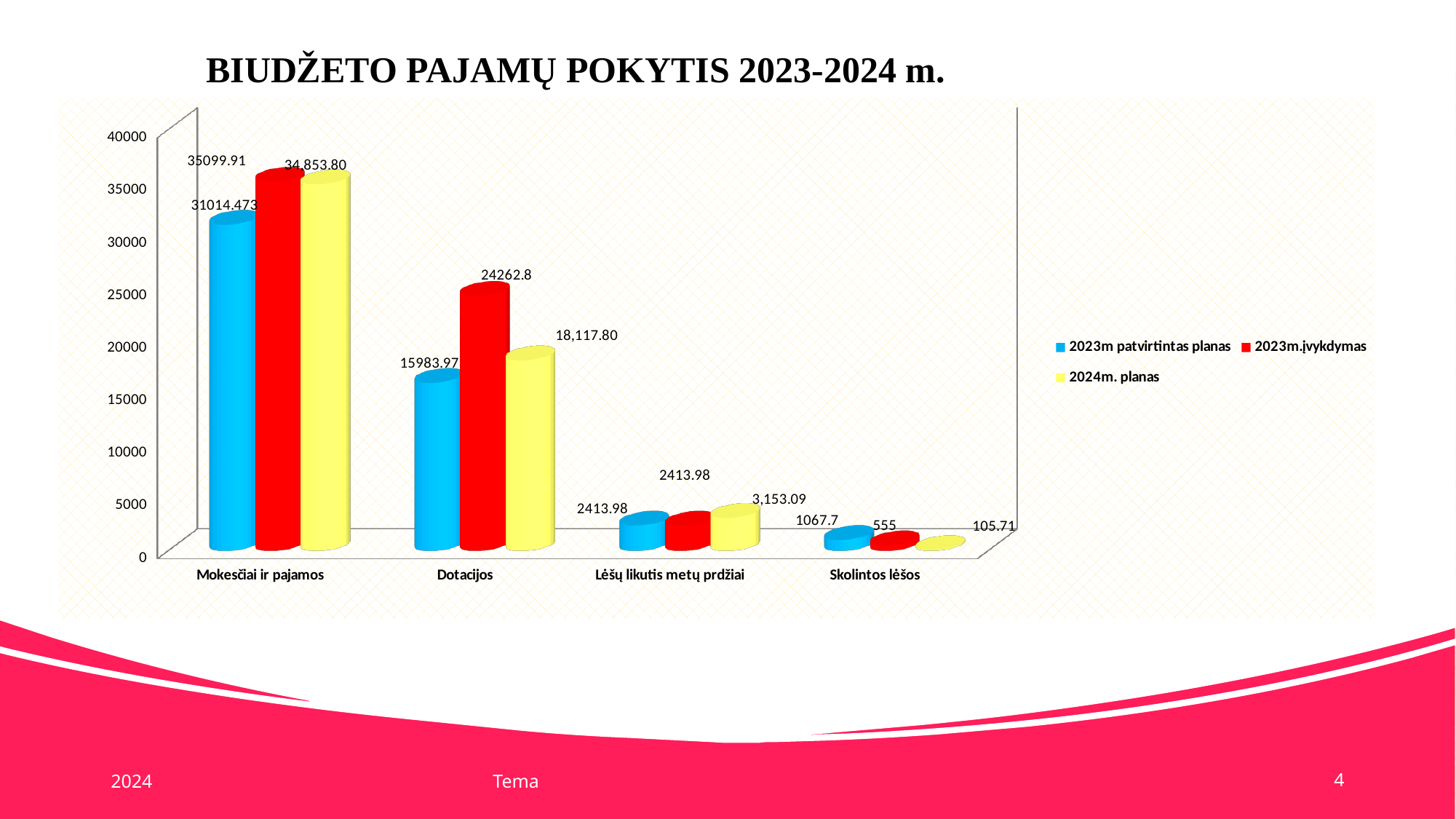
What is the difference between 2023m.įvykdymas and 2023m patvirtintas planas for Dotacijos? 8278.83 Is the value of 2024m. planas for Dotacijos greater or less than 20000? less What is the value of 2024m. planas for Lėšų likutis metų prdžiai? 3,153.09 How many categories are shown on the x axis? 4 Which category has the lowest value for 2024m. planas? Skolintos lėšos What type of chart is shown on the slide? Bar chart What is the value of 2024m. planas for Skolintos lėšos? 105.71 What is the value of 2023m.įvykdymas for Dotacijos? 24262.8 For Skolintos lėšos, which is larger: 2023m patvirtintas planas or 2023m.įvykdymas? 2023m patvirtintas planas How many series does the legend list? 3 What is the value of 2023m patvirtintas planas for Mokesčiai ir pajamos? 31014.473 Which category has the highest value for 2023m.įvykdymas? Mokesčiai ir pajamos